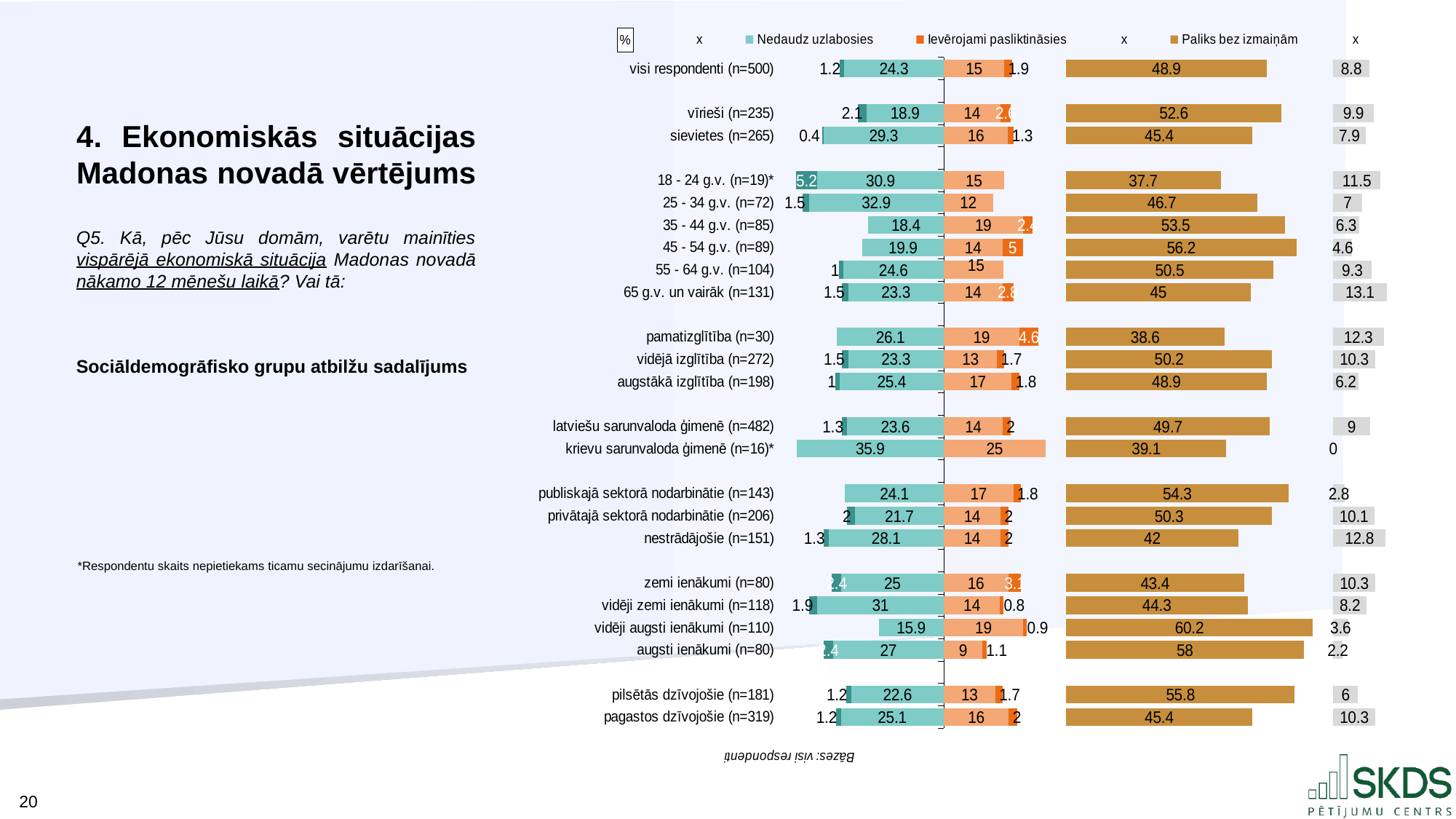
How many named series does the legend list? 3 Which group has the lowest value for 'Nedaudz uzlabosies'? vidēji augsti ienākumi (n=110) Which group has the lowest value for 'Paliks bez izmaiņām'? 18 - 24 g.v. (n=19)* What is the value of 'Nedaudz uzlabosies' for 'krievu sarunvaloda ģimenē (n=16)*'? 35.9 What is the value of 'Paliks bez izmaiņām' for 'visi respondenti (n=500)'? 48.9 How many respondent groups (rows) are shown in the chart? 23 What is the difference between the 'Paliks bez izmaiņām' values for 'vīrieši (n=235)' and 'sievietes (n=265)'? 7.2 What type of chart is shown on the slide? Stacked horizontal bar chart Which group has the highest value for 'Paliks bez izmaiņām'? vidēji augsti ienākumi (n=110) What is the value of 'Ievērojami pasliktināsies' for '45 - 54 g.v. (n=89)'? 5 What is the difference between the 'Nedaudz uzlabosies' values for 'sievietes (n=265)' and 'vīrieši (n=235)'? 10.4 Which has the larger 'Paliks bez izmaiņām' value: 'pilsētās dzīvojošie (n=181)' or 'pagastos dzīvojošie (n=319)'? pilsētās dzīvojošie (n=181)